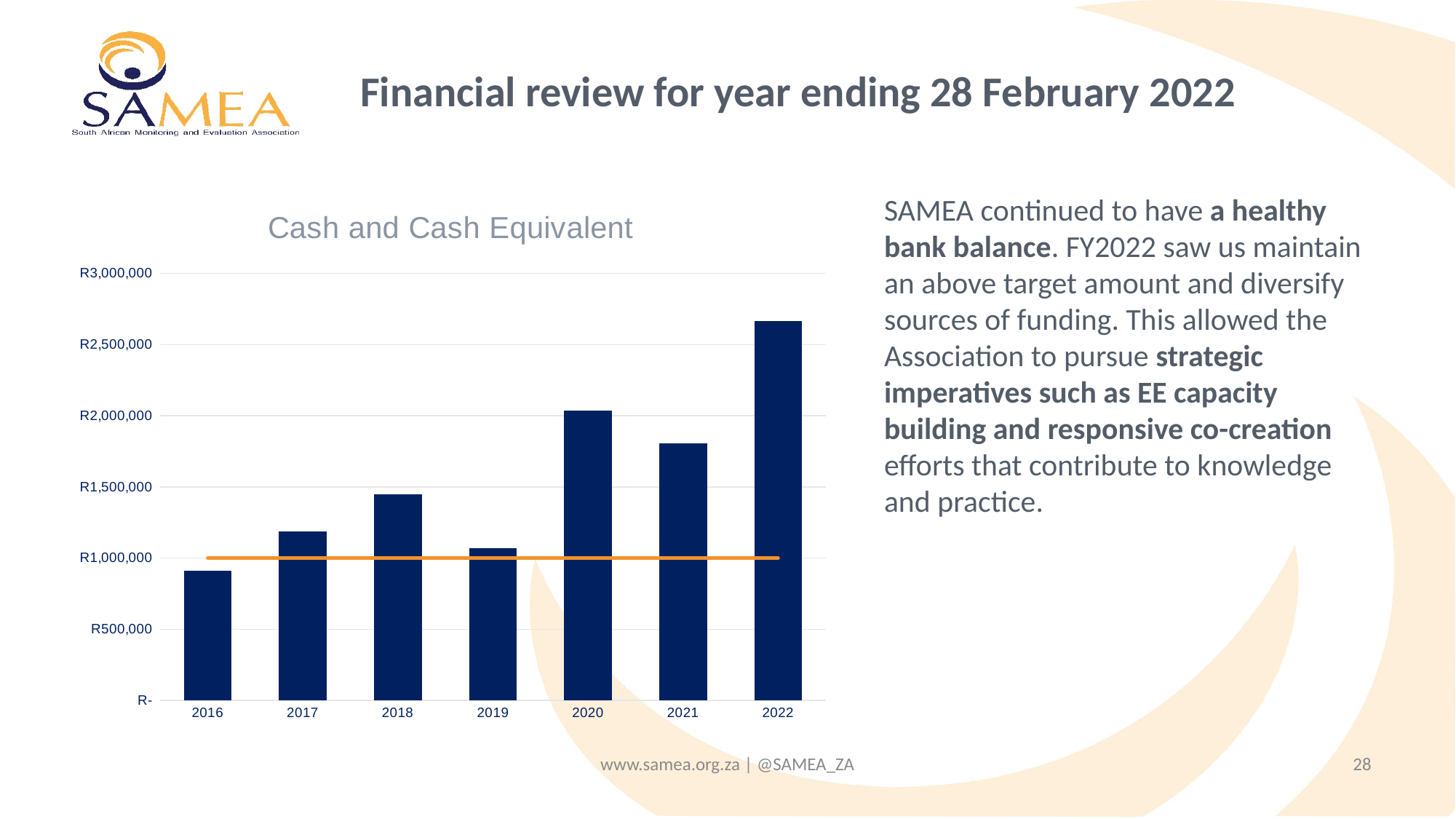
How many years are plotted on the x axis of the chart? 7 At what level on the y axis does the horizontal orange line sit? R1,000,000 What kind of chart is shown on the slide? Combination bar and line chart Is the value for 2016 greater or less than R1,000,000? less Is the value for 2021 greater or less than R2,000,000? less What is the title of the chart? Cash and Cash Equivalent Which year has the lowest cash and cash equivalent value? 2016 Is the value for 2017 greater or less than R1,000,000? greater Which year has the highest cash and cash equivalent value? 2022 Which year has the larger value, 2017 or 2018? 2018 Which year has the larger value, 2020 or 2021? 2020